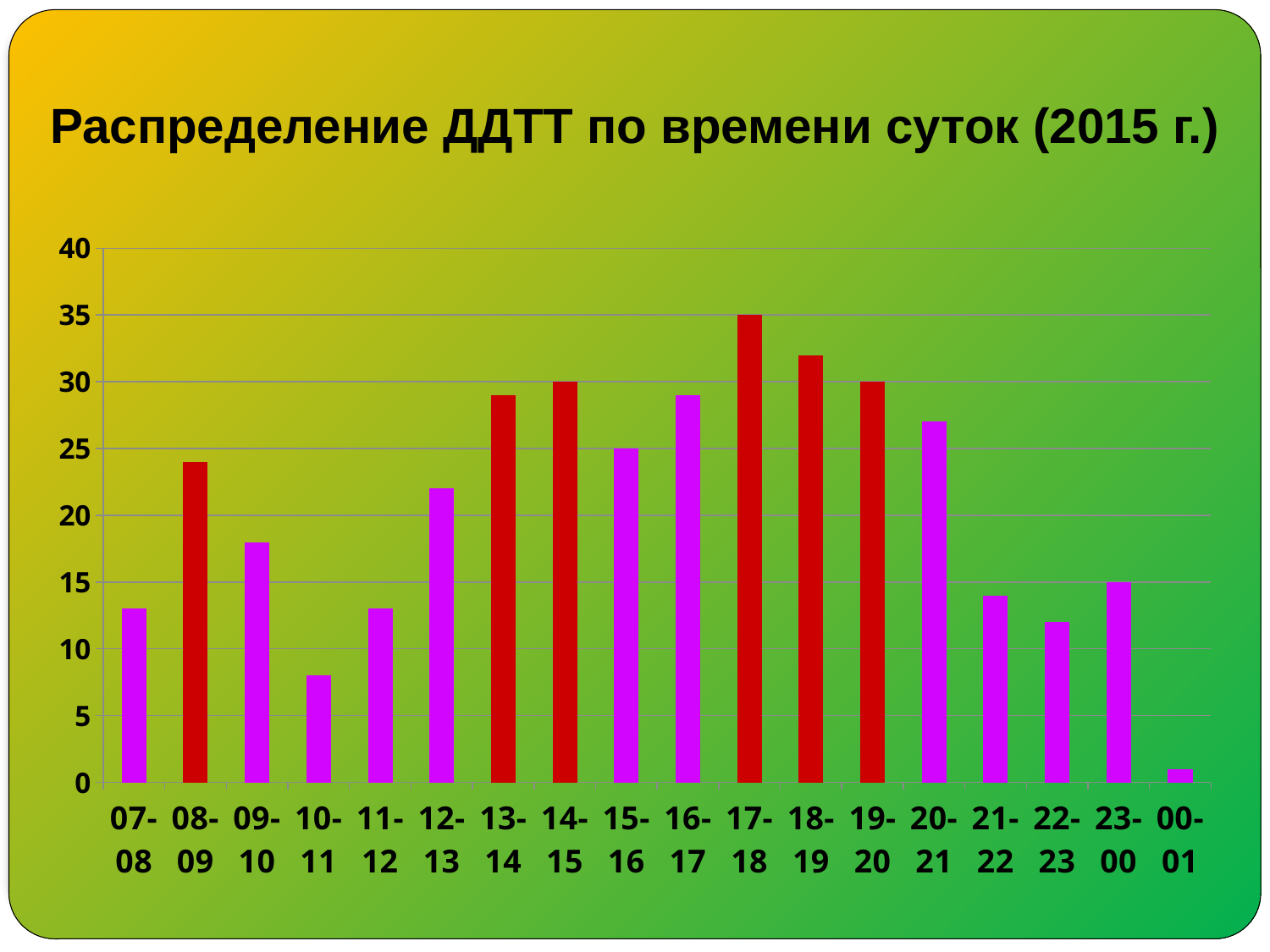
Which time interval has the highest value? 17-18 Is the value for the 10-11 interval greater or less than 10? less Which is larger, the value for 12-13 or the value for 21-22? 12-13 What is the value for the 23-00 interval? 15 Is the value for the 18-19 interval greater or less than 30? greater What kind of chart is shown on the slide? bar chart What is the title of the chart? Распределение ДДТТ по времени суток (2015 г.) Is the value for the 08-09 interval greater or less than 20? greater What is the value for the 15-16 interval? 25 Which time interval has the lowest value? 00-01 How many time-of-day categories are shown on the x axis? 18 What is the value for the 17-18 interval? 35